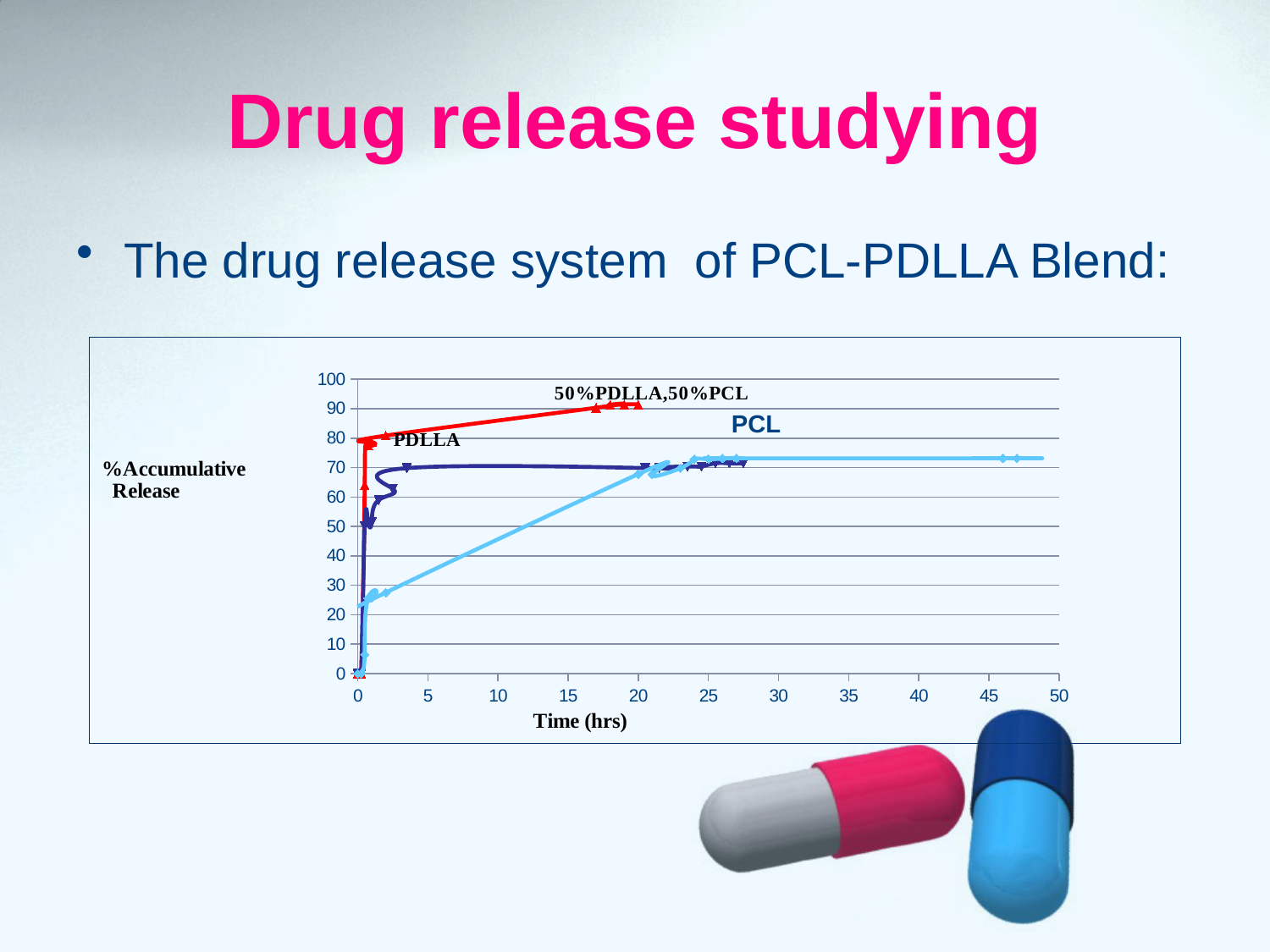
What kind of chart is shown on the slide? line chart Is the value for PCL at 45 hrs greater or less than 60? greater What is the label of the y axis? %Accumulative Release Which series has the lowest value at 10 hrs? PCL Which series reaches the highest %Accumulative Release on the chart? 50%PDLLA,50%PCL At 20 hrs, which series has the larger value, 50%PDLLA,50%PCL or PCL? 50%PDLLA,50%PCL What is the label of the x axis? Time (hrs) Is the value for PDLLA at 25 hrs greater or less than 60? greater How many series are plotted on the chart? 3 Is the value for PCL at 10 hrs greater or less than 50? less Does the PCL series rise or fall between 0 and 20 hrs? rise